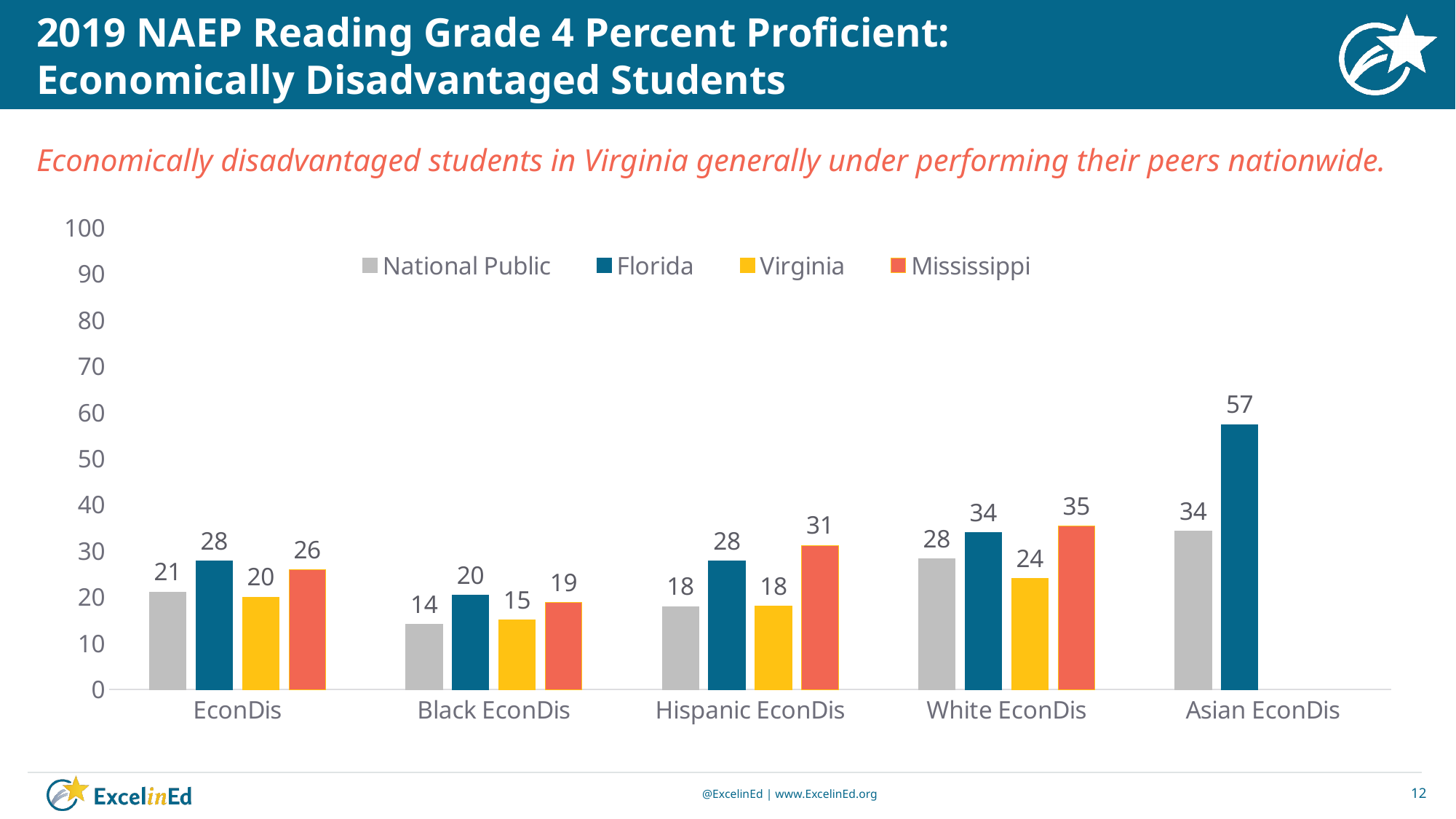
What kind of chart is shown on the slide? Bar chart What is the value for Mississippi in the Hispanic EconDis category? 31 Which series is shown in yellow? Virginia Which category has the lowest Virginia value? Black EconDis What is the value for Florida in the Asian EconDis category? 57 What is the difference between the Florida and Virginia values in the EconDis category? 8 In the White EconDis category, which is larger: the Mississippi value or the National Public value? Mississippi What is the value for Virginia in the White EconDis category? 24 What is the value for National Public in the Black EconDis category? 14 How many series does the legend list? 4 How many categories are shown on the x axis? 5 Which category has the highest Florida value? Asian EconDis